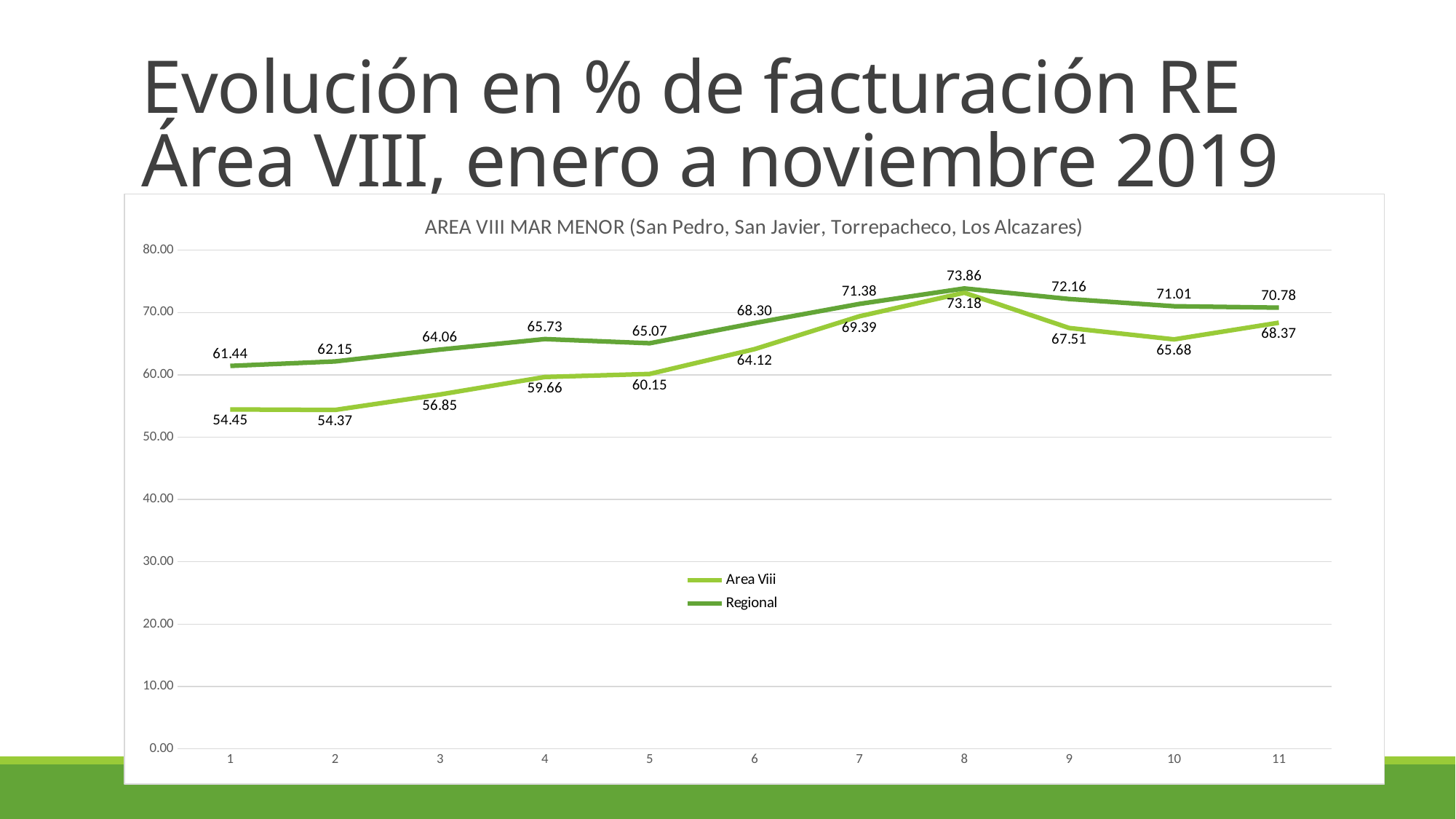
What is the value for Regional at point 8? 73.86 Which series has the larger value at point 11, Area Viii or Regional? Regional What is the value for Area Viii at point 10? 65.68 At which point does the Area Viii series have its lowest value? 2 How many points are plotted along the x axis for each series? 11 What is the title of the chart? AREA VIII MAR MENOR (San Pedro, San Javier, Torrepacheco, Los Alcazares) How many series does the legend list? 2 What kind of chart is shown on the slide? Line chart Does the Regional series rise or fall from point 1 to point 8? Rise What is the value for Area Viii at point 1? 54.45 At which point does the Area Viii series reach its highest value? 8 What is the difference between Regional and Area Viii at point 1? 6.99